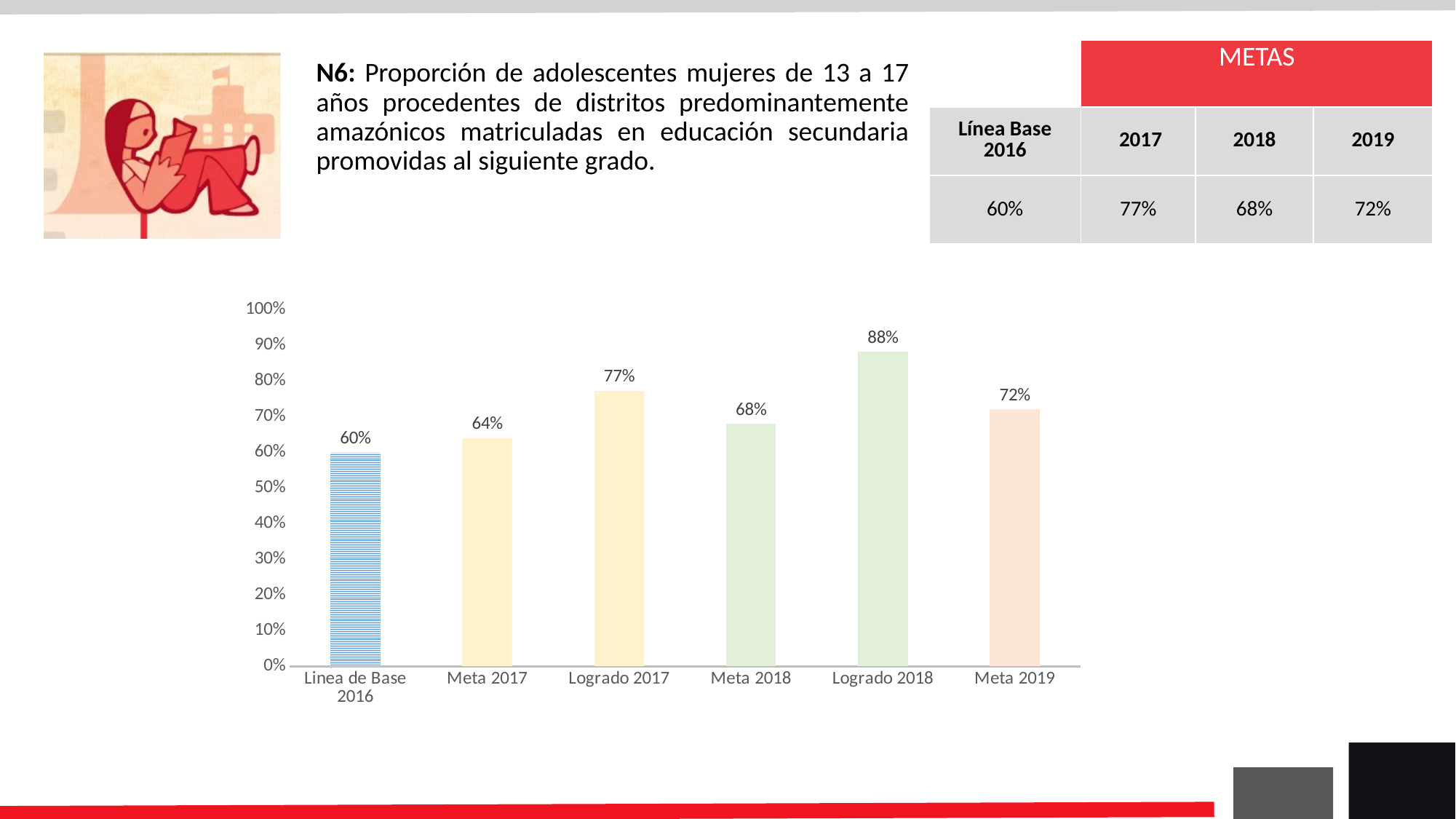
Which category has the lowest value? Linea de Base 2016 What is the highest value shown on the y axis? 100% Is the value for Logrado 2017 greater or less than 70%? greater Which is larger, Meta 2019 or Meta 2018? Meta 2019 What kind of chart is shown on the slide? bar chart What is the value for Meta 2017? 64% What is the value for Logrado 2018? 88% What is the value for Linea de Base 2016? 60% Which category has the highest value? Logrado 2018 What is the difference between Logrado 2017 and Meta 2017? 13% How many categories are shown on the x axis? 6 What is the difference between Logrado 2018 and Meta 2018? 20%